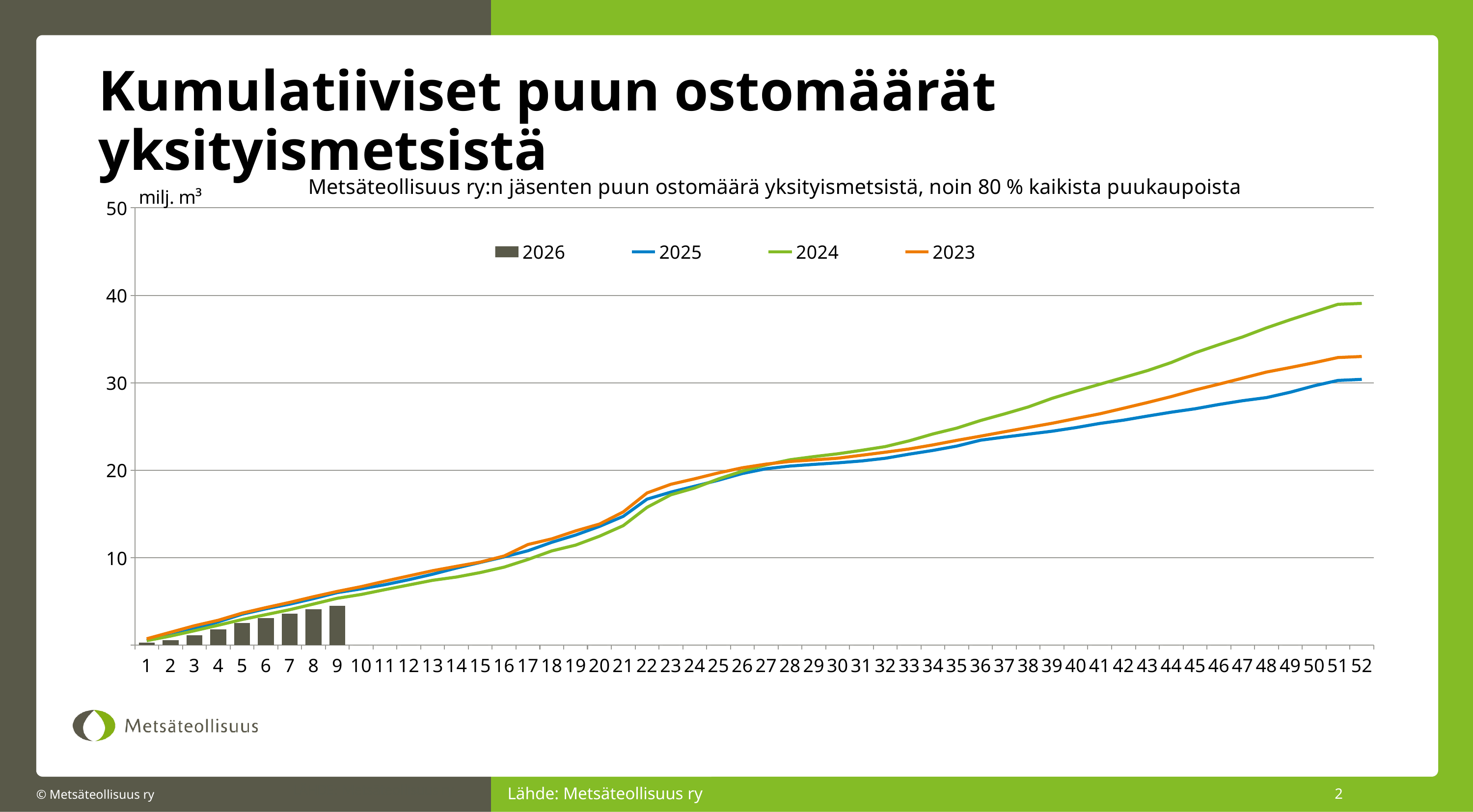
Which series has the highest value at week 52? 2024 What kind of chart is shown on the slide? A combined bar and line chart How many series does the chart legend list? 4 Is the value for 2024 at week 52 greater or less than 30? greater Which series has the lowest value at week 52? 2025 What unit is shown on the y axis of the chart? milj. m³ Do the line series rise or fall as the week number increases? rise Is the value for the 2026 bar at week 9 greater or less than 10? less Is the value for 2025 at week 52 greater or less than 40? less How many weeks are shown on the x axis of the chart? 52 At week 52, which is larger: the value for 2023 or the value for 2025? 2023 For how many weeks are bars plotted for the 2026 series? 9